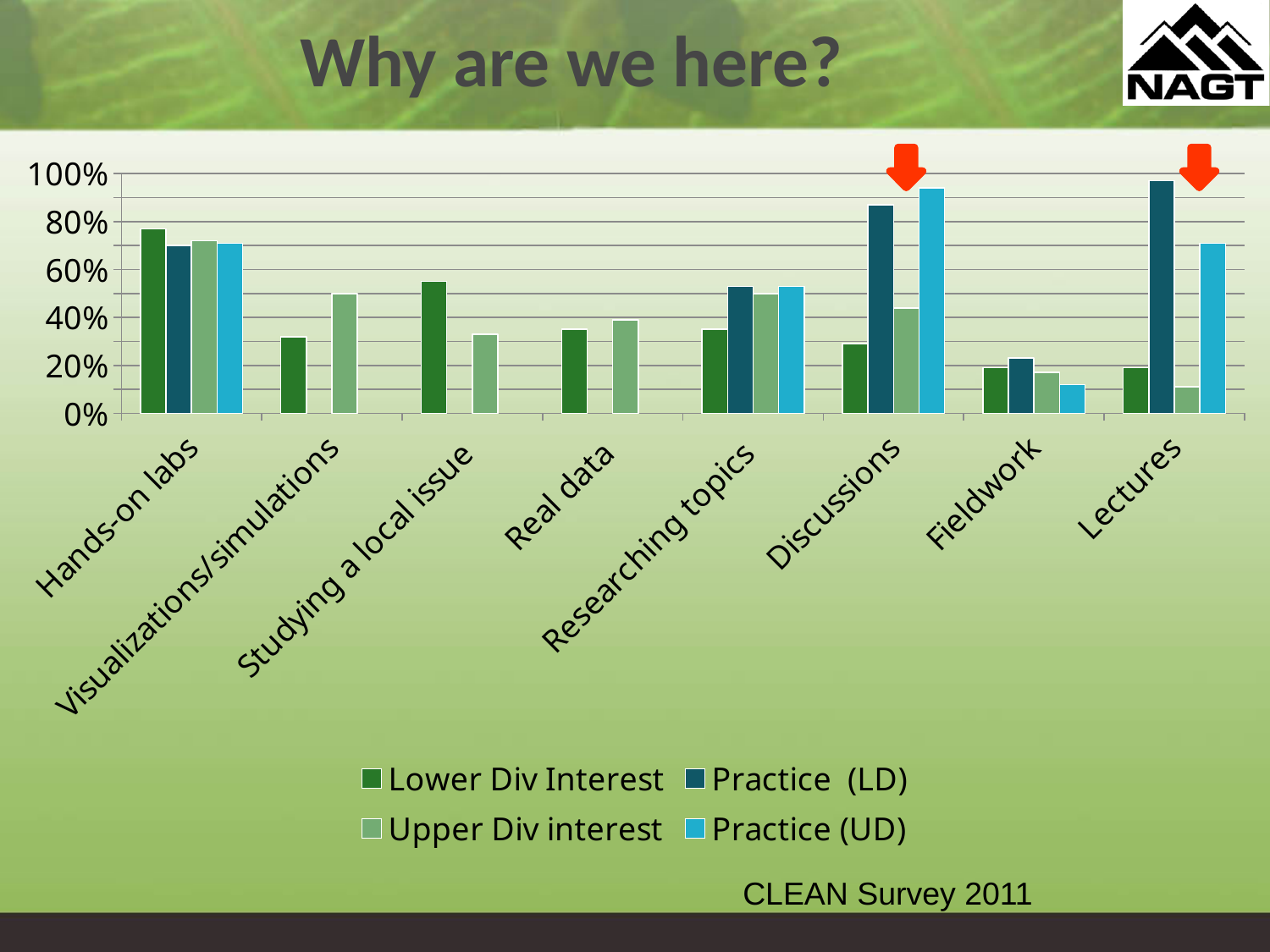
How many categories are shown on the x axis? 8 For Lectures, which is larger: Practice (LD) or Practice (UD)? Practice (LD) Which category has the highest Practice (LD) value? Lectures What source is cited below the chart? CLEAN Survey 2011 Which category has the highest Lower Div Interest value? Hands-on labs Is the Practice (UD) value for Discussions greater or less than 80%? greater How many series does the legend list? 4 Is the Lower Div Interest value for Studying a local issue greater or less than 40%? greater Which category has the lowest Upper Div interest value? Lectures For Discussions, which is larger: Practice (UD) or Upper Div interest? Practice (UD) Is the Lower Div Interest value for Lectures greater or less than 40%? less What kind of chart is shown on the slide? Bar chart